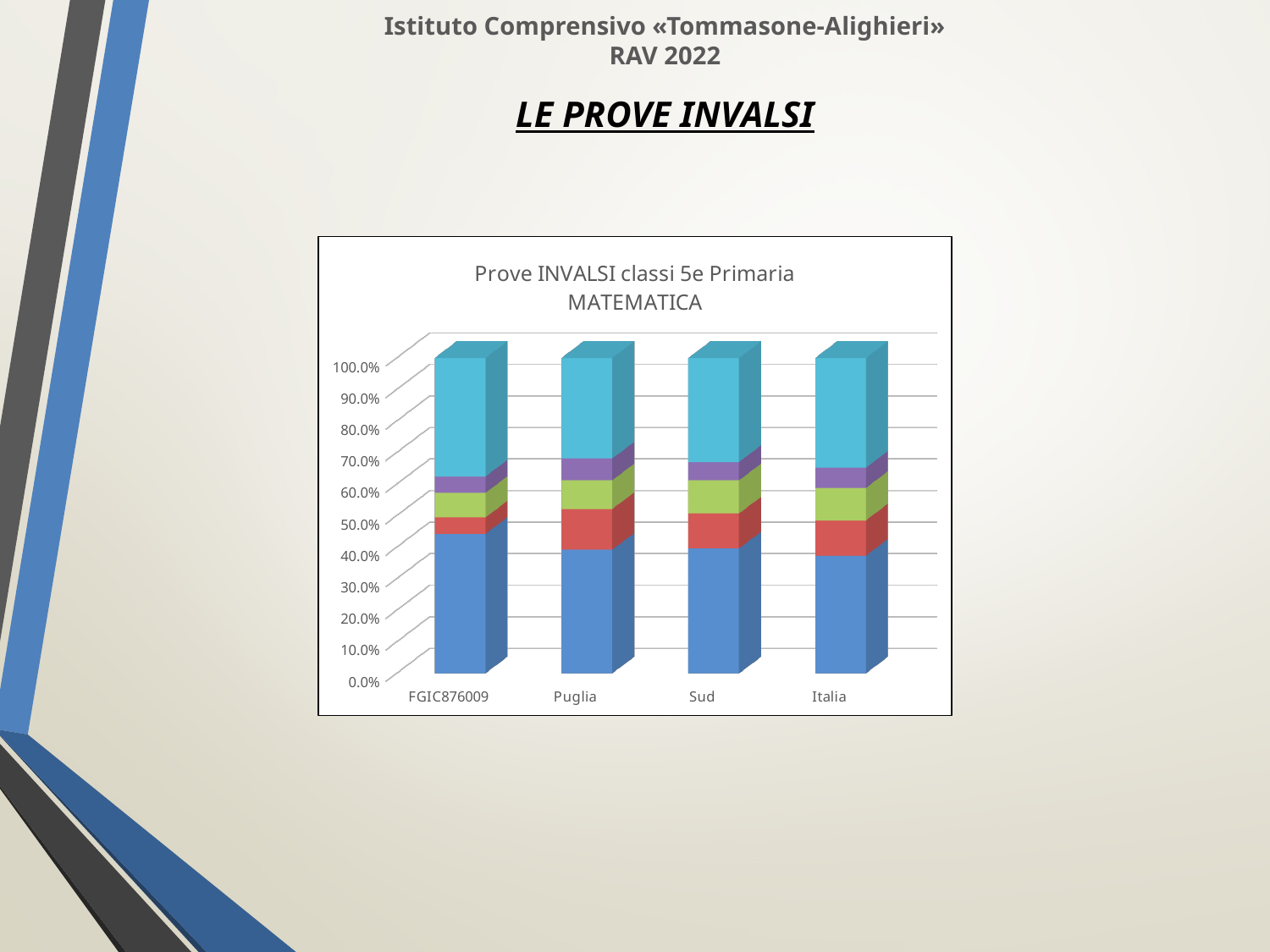
Is the bottom (dark blue) segment for Italia greater or less than 50%? less Is the top of the purple segment for Puglia greater or less than 60% on the vertical axis? greater Is the bottom (dark blue) segment for FGIC876009 greater or less than 40%? greater What is the highest value labelled on the vertical axis of the chart? 100.0% Which category is listed first on the x axis of the chart? FGIC876009 Which category has the smallest top (light blue) segment? Puglia What is the title of the chart? Prove INVALSI classi 5e Primaria MATEMATICA Is the purple segment larger for Italia or for FGIC876009? Italia What kind of chart is shown on the slide? stacked bar chart How many categories are shown on the x axis of the chart? 4 Which category has the largest top (light blue) segment? FGIC876009 Is the bottom (dark blue) segment larger for FGIC876009 or for Italia? FGIC876009